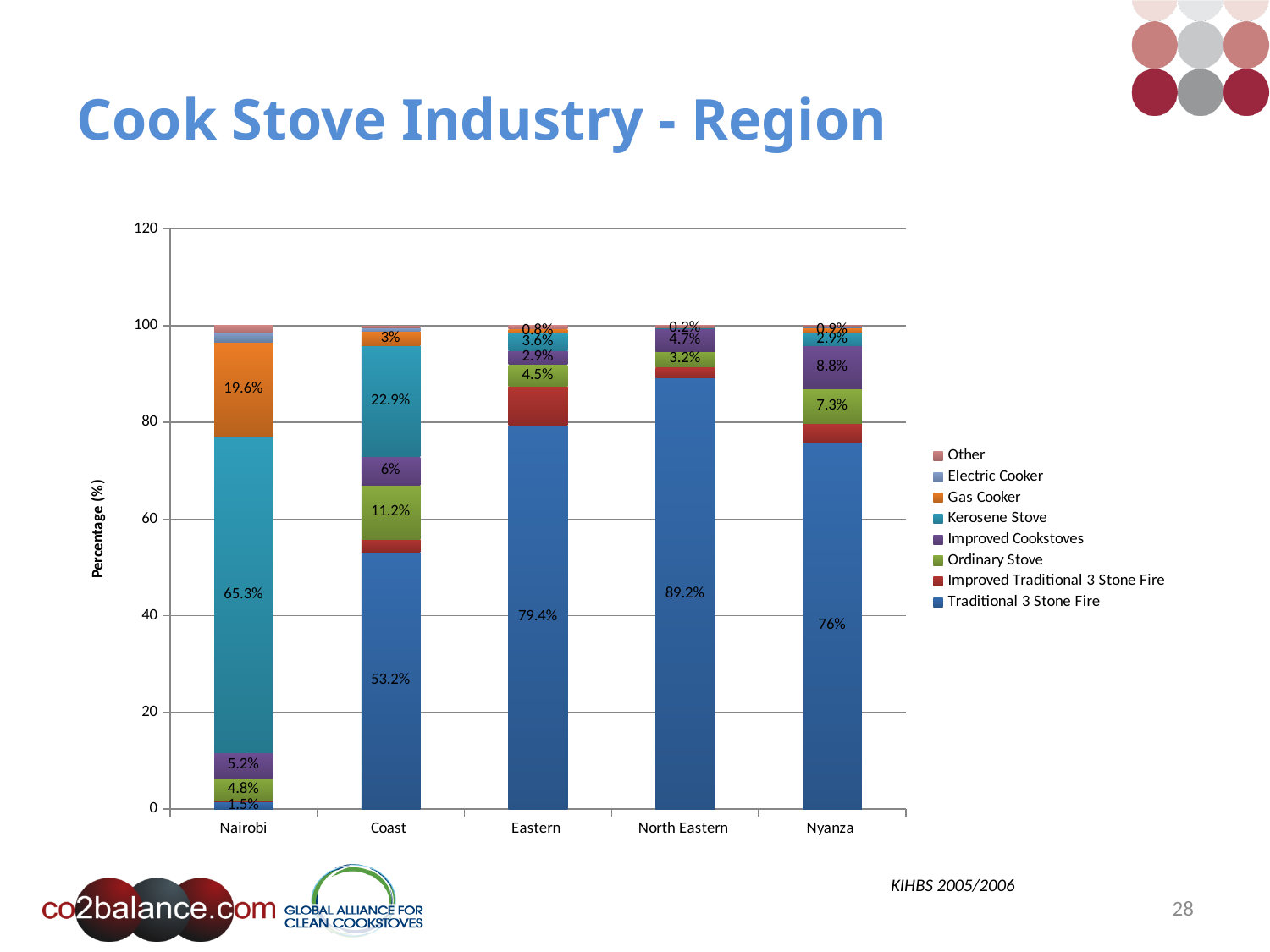
What is the title of the chart's vertical axis? Percentage (%) What is the Kerosene Stove value for Nairobi? 65.3% Which region has the highest Traditional 3 Stone Fire value? North Eastern Which region has the larger Kerosene Stove value, Nairobi or Coast? Nairobi What is the Gas Cooker value for Nairobi? 19.6% How many regions are shown on the x axis of the chart? 5 How many series does the chart's legend list? 8 Which region has the lowest Traditional 3 Stone Fire value? Nairobi What is the Traditional 3 Stone Fire value for Coast? 53.2% What type of chart is shown on the slide? Stacked bar chart What is the difference between the Traditional 3 Stone Fire values for North Eastern and Eastern? 9.8 percentage points What is the Improved Cookstoves value for Nyanza? 8.8%